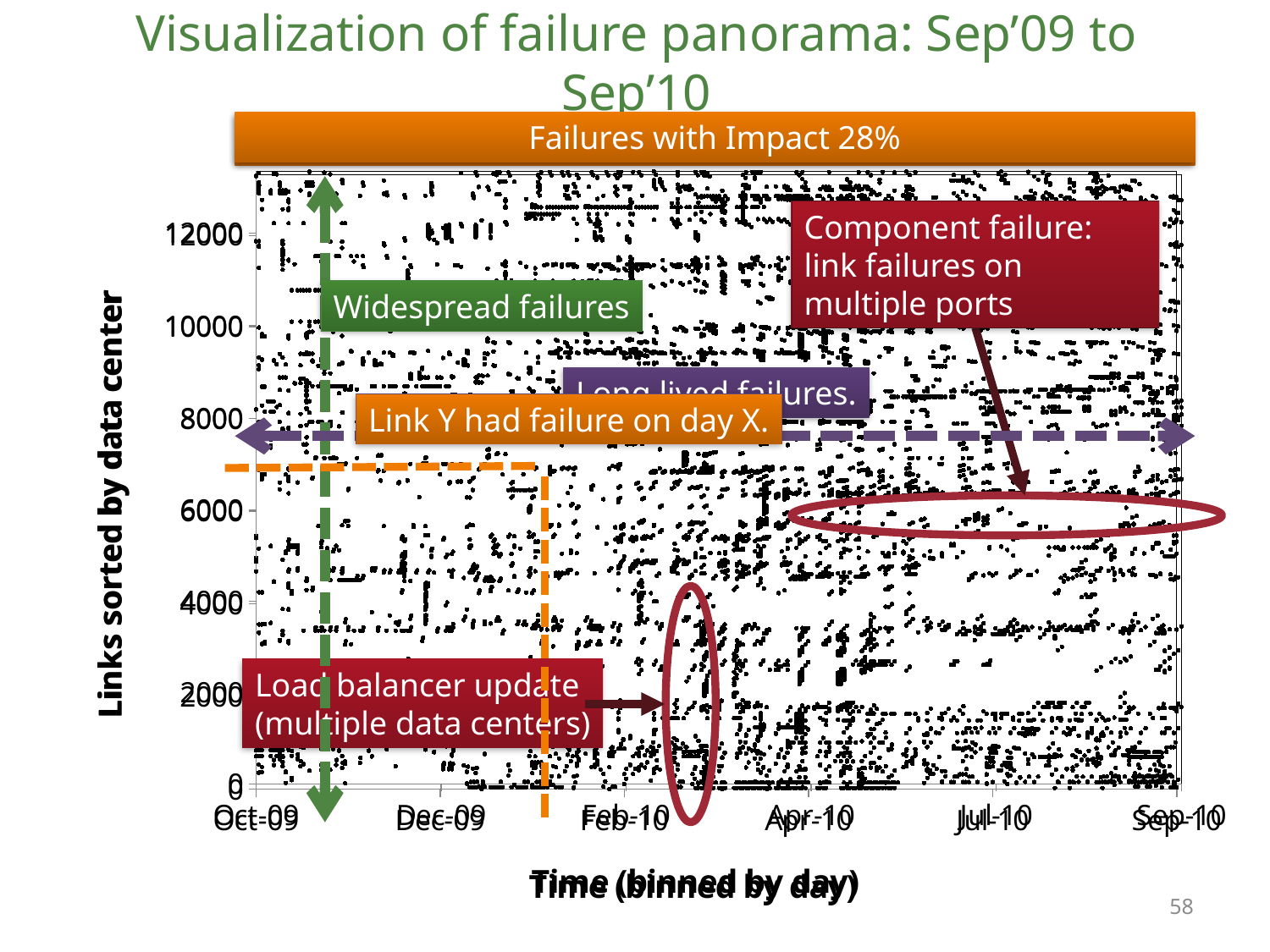
What is the label of the x axis of the chart? Time (binned by day) What is the label of the y axis of the chart? Links sorted by data center How many tick labels are shown along the x axis of the chart? 6 What kind of chart is shown on the slide? scatter plot What percentage of failures with impact is stated in the banner above the chart? 28%